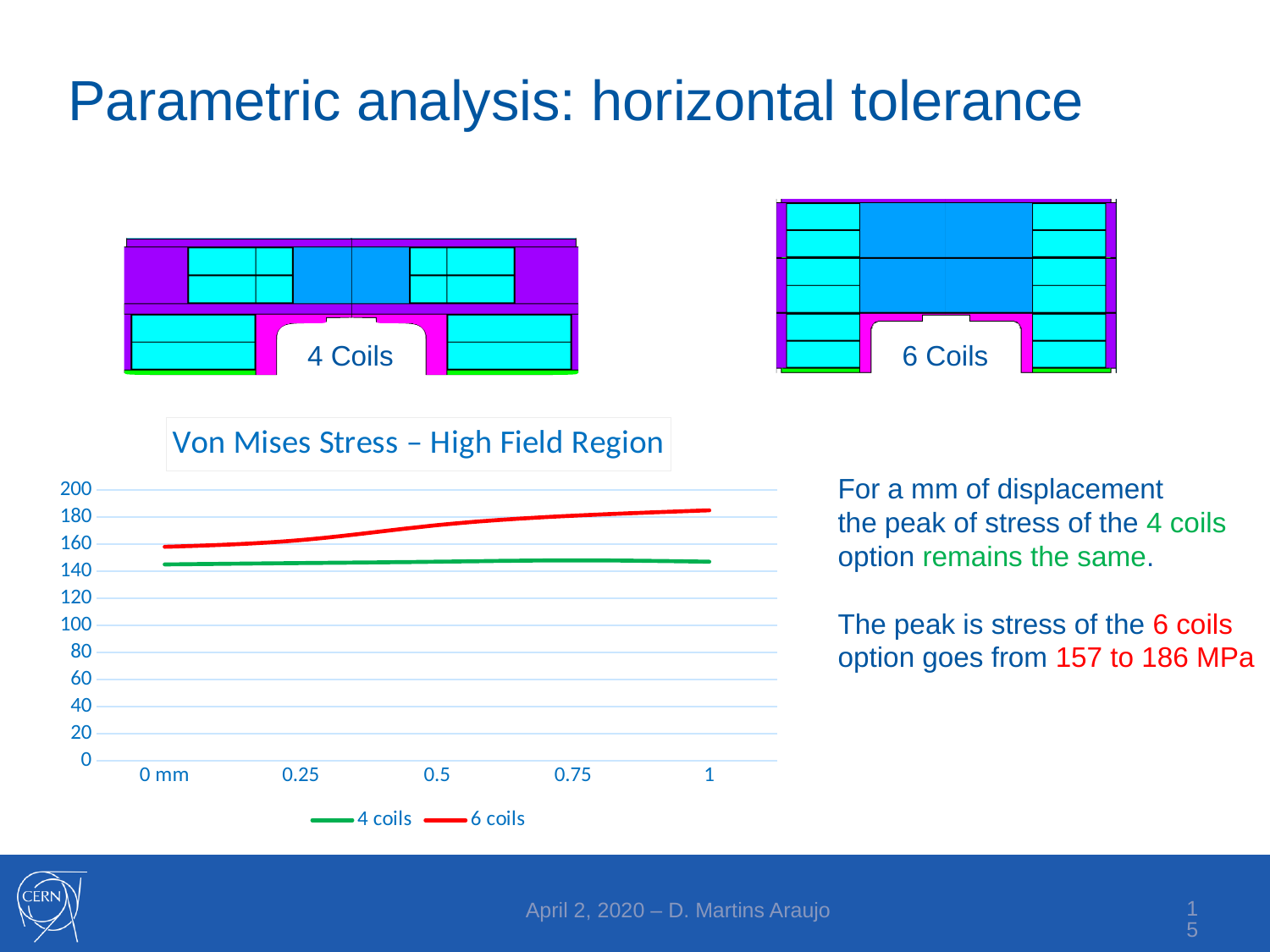
In the Von Mises Stress chart, is the value for 6 coils at a displacement of 1 greater or less than 160? greater What kind of chart is shown under the title 'Von Mises Stress – High Field Region'? line chart How many displacement values are marked along the x axis of the Von Mises Stress chart? 5 In the Von Mises Stress chart, is the value for 4 coils at a displacement of 0.5 greater or less than 160? less In the Von Mises Stress chart, is the value for 6 coils at 0 mm greater or less than 140? greater How many series does the legend of the Von Mises Stress chart list? 2 What colour is the 6 coils line in the Von Mises Stress chart? red According to the slide, what is the peak stress of the 6 coils option at 0 mm of displacement? 157 MPa According to the slide, what is the peak stress of the 6 coils option at 1 mm of displacement? 186 MPa In the Von Mises Stress chart, does the 6 coils line rise or fall as displacement increases from 0 mm to 1? rise In the Von Mises Stress chart, which series is higher at a displacement of 1, 4 coils or 6 coils? 6 coils